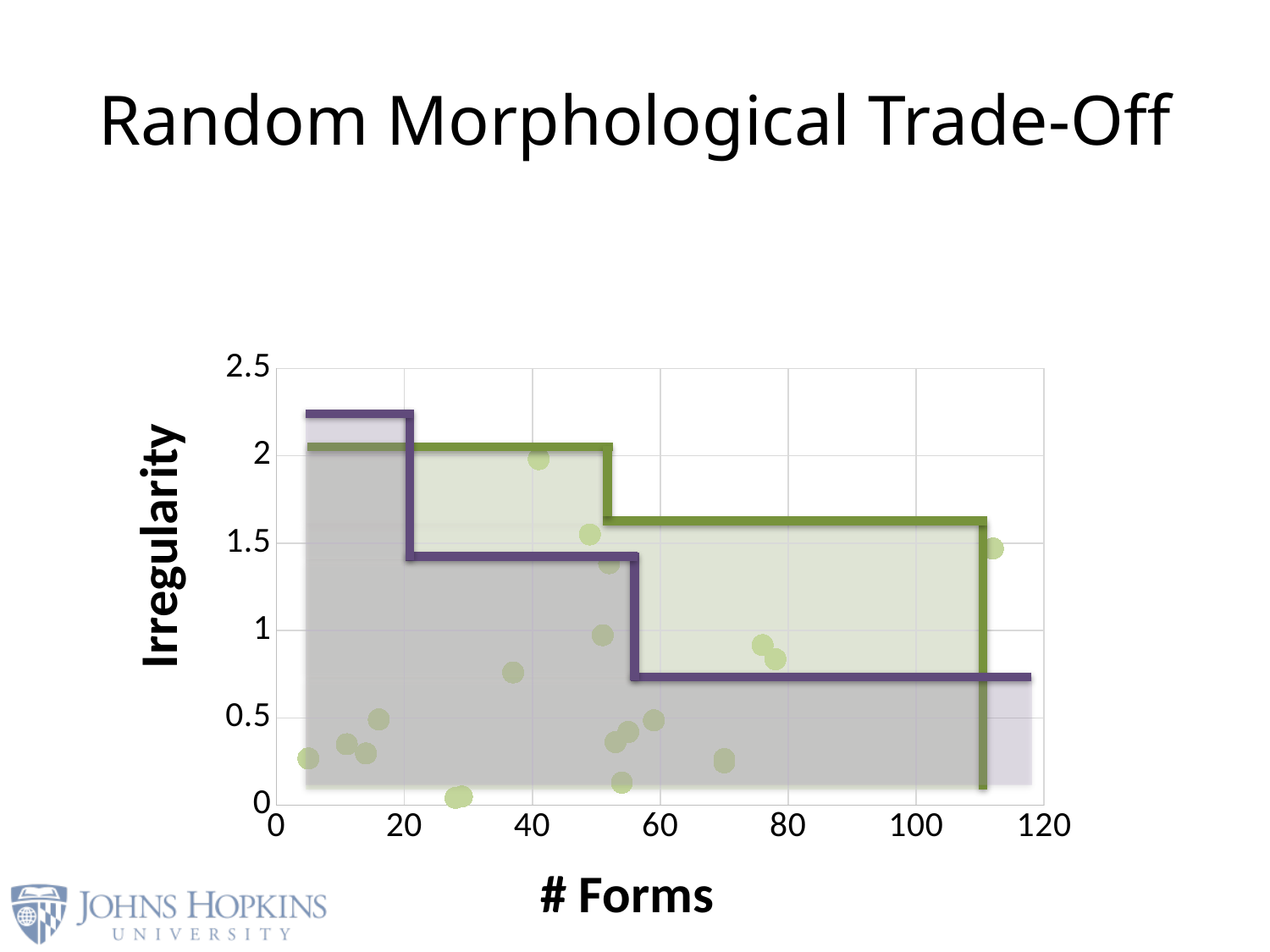
What is the label of the x axis? # Forms What is the label of the y axis? Irregularity How many step lines are drawn on the chart? 2 What is the highest value shown on the y axis? 2.5 Is the purple step line's value at 100 forms greater or less than 1? less Do the step lines rise or fall as the number of forms increases? fall Is the purple step line's value at 10 forms greater or less than 2? greater At 10 forms, which step line is higher, the green one or the purple one? purple At 80 forms, which step line is higher, the green one or the purple one? green Is the green step line's value at 100 forms greater or less than 1.5? greater